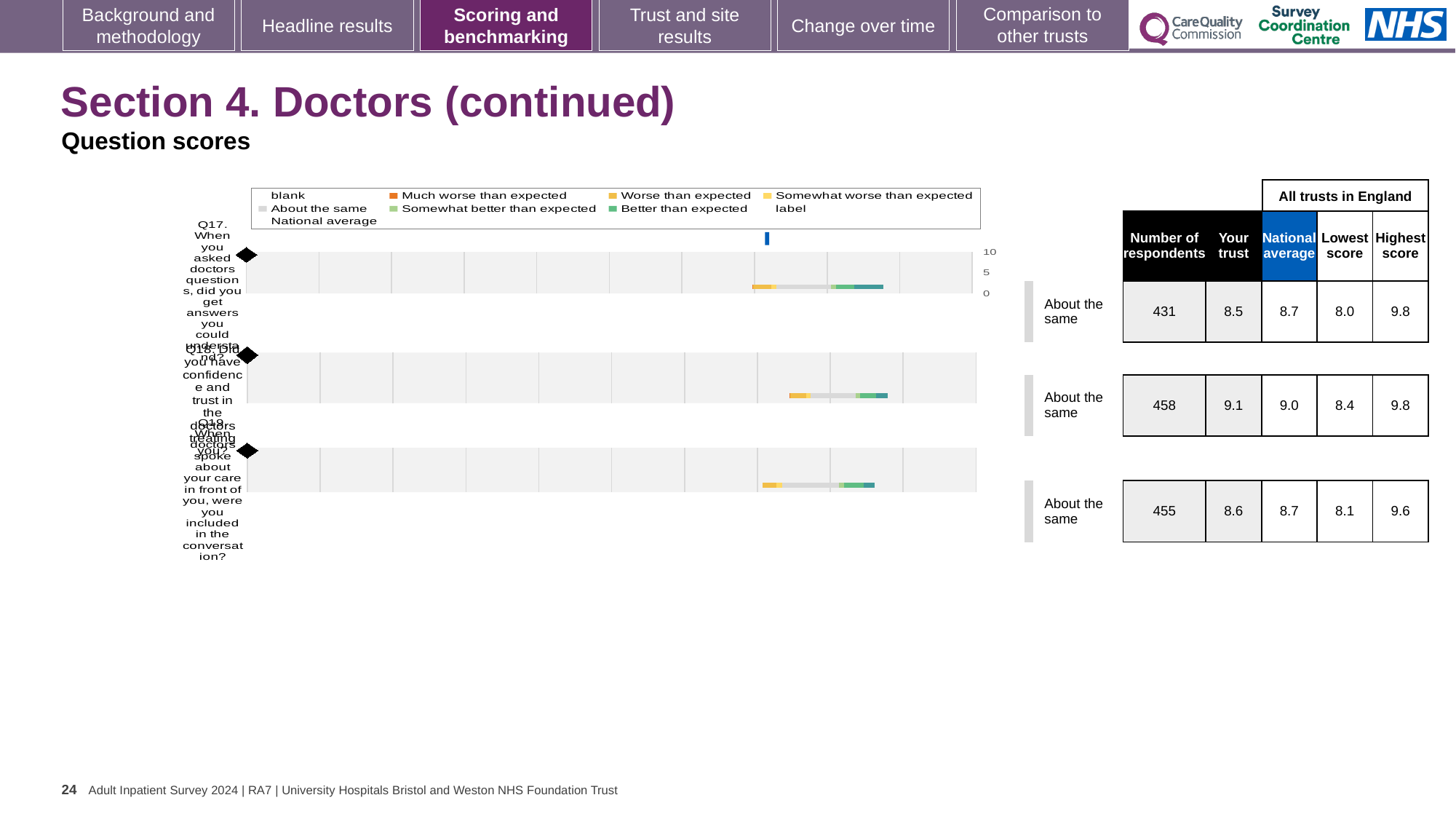
Which question has the highest 'Your trust' score on this slide? Q18 What is the difference between the 'Your trust' score and the national average for Q18? 0.1 How many questions are plotted on the chart? 3 What is the national average score for Q18 (Did you have confidence and trust in the doctors treating you)? 9.0 What is the lowest score across all trusts in England for Q18? 8.4 For Q17, which is larger: the 'Your trust' score or the national average? National average Is the 'Your trust' score for Q19 greater or less than 5 on the chart's axis? greater What is the 'Your trust' score for Q17 (When you asked doctors questions, did you get answers you could understand)? 8.5 Which question has the lowest 'Your trust' score on this slide? Q17 What benchmark category is shown for Q18? About the same How many respondents answered Q19 (When doctors spoke about your care in front of you, were you included in the conversation)? 455 What kind of chart is used to show the question scores? Bar chart